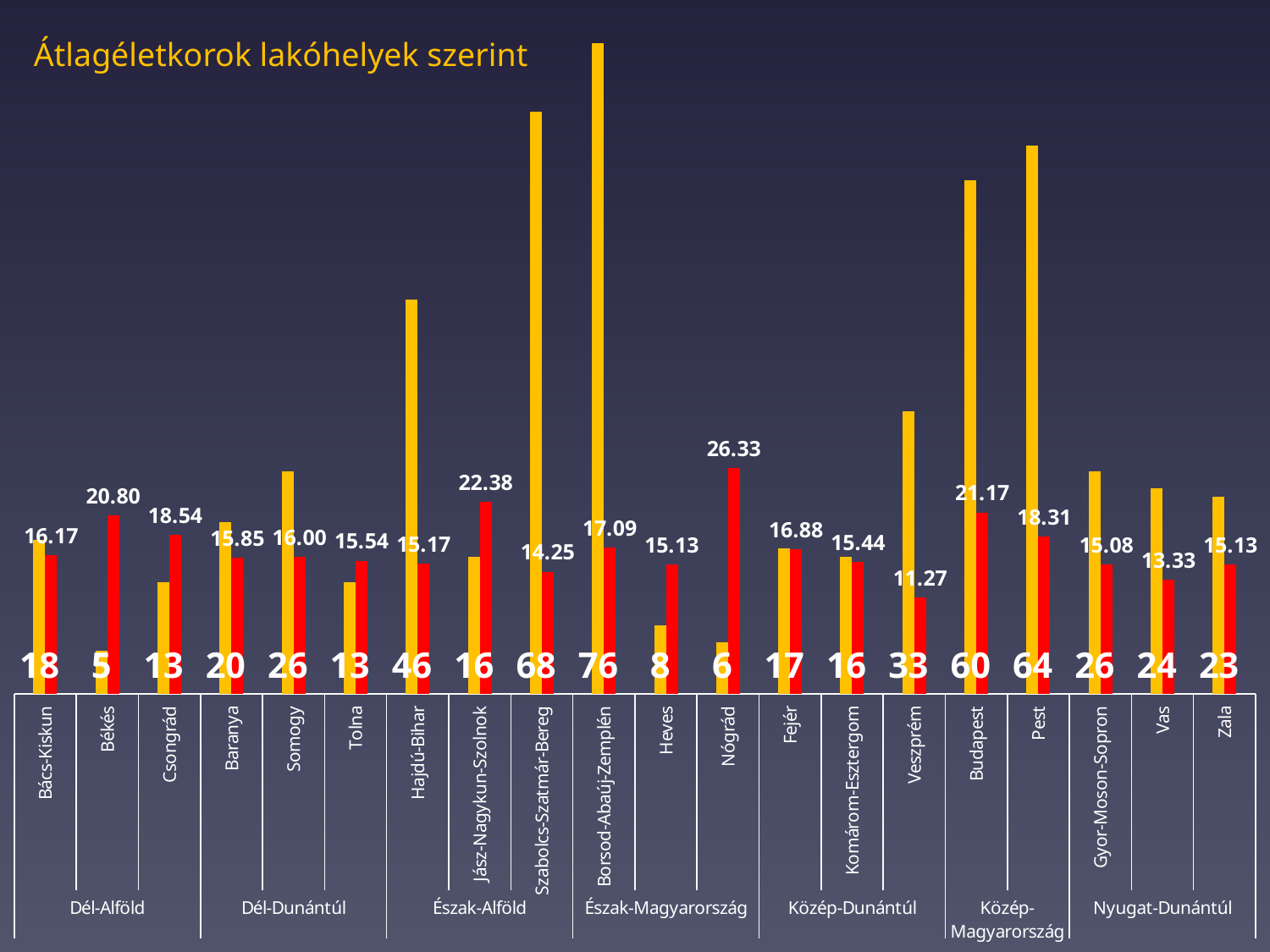
How many regional groups are labelled beneath the county names? 7 Which county has the highest yellow bar value? Borsod-Abaúj-Zemplén Which county has the lowest yellow bar value? Békés Which county has the highest red bar value? Nógrád What is the value of the yellow bar for Borsod-Abaúj-Zemplén? 76 What is the title of the chart? Átlagéletkorok lakóhelyek szerint How many counties (categories) are shown along the x axis? 20 What is the difference between the yellow bar values for Pest and Budapest? 4 Which county has the lowest red bar value? Veszprém What kind of chart is shown on the slide? bar chart What is the value of the red bar for Nógrád? 26.33 Which has the larger red bar value, Békés or Csongrád? Békés